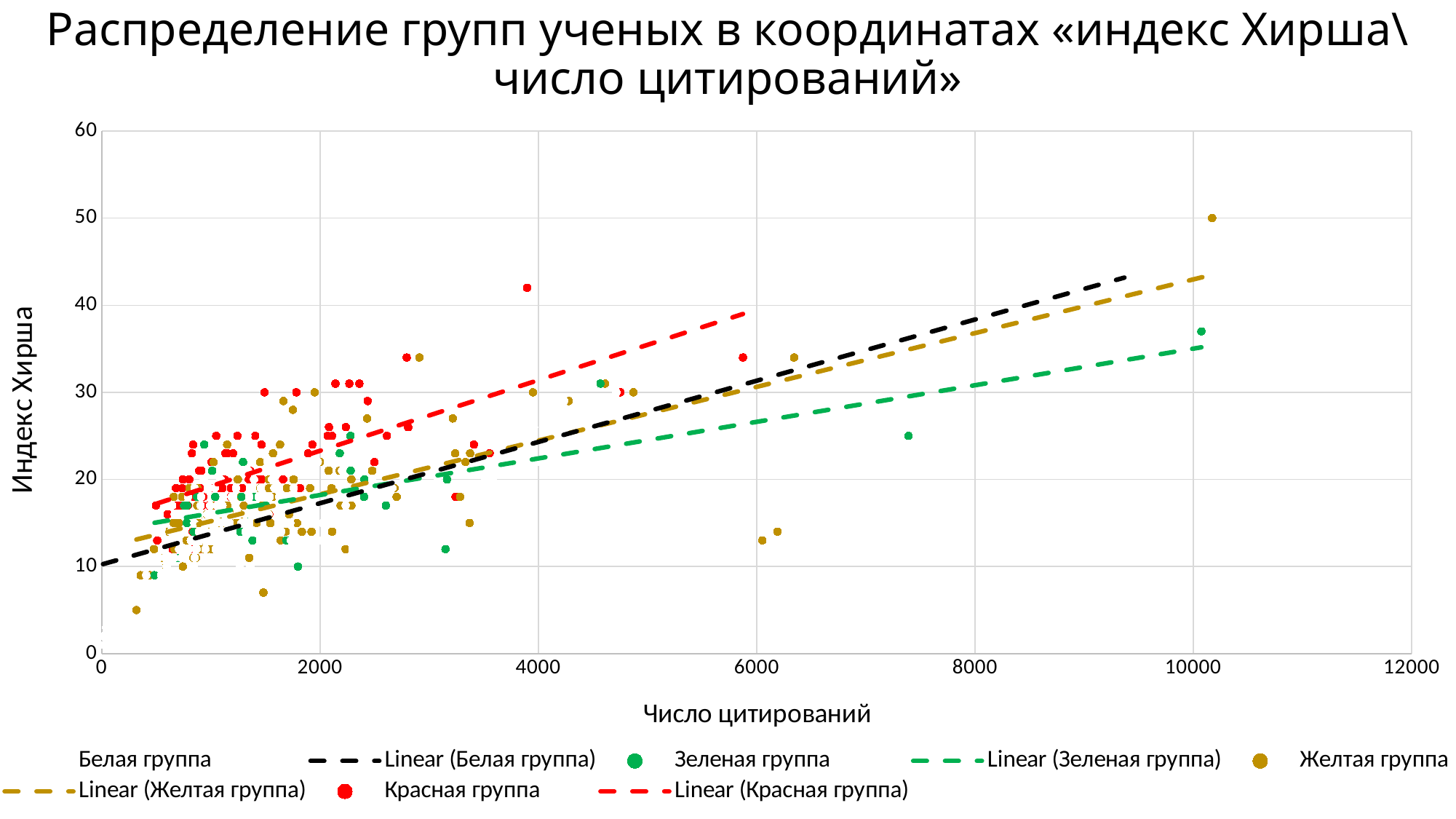
Do the dashed linear trend lines rise or fall as the number of citations increases? rise How many groups of scientists (point series) are plotted on the chart? 4 Which group's linear trend line has the shallowest slope? Зеленая группа What is the maximum value shown on the vertical axis (Индекс Хирша)? 60 How many entries does the legend list? 8 Is the Hirsch index of the rightmost yellow-group point (near 10000 citations) greater or less than 40? greater Is the Hirsch index of the rightmost green-group point (near 10000 citations) greater or less than 40? less What is the label of the horizontal axis? Число цитирований What is the title of the chart? Распределение групп ученых в координатах «индекс Хирша\ число цитирований» What kind of chart is shown on the slide? scatter chart Is the Hirsch index of the highest red-group point (near 4000 citations) greater or less than 40? greater Which group's linear trend line has the steepest slope? Красная группа